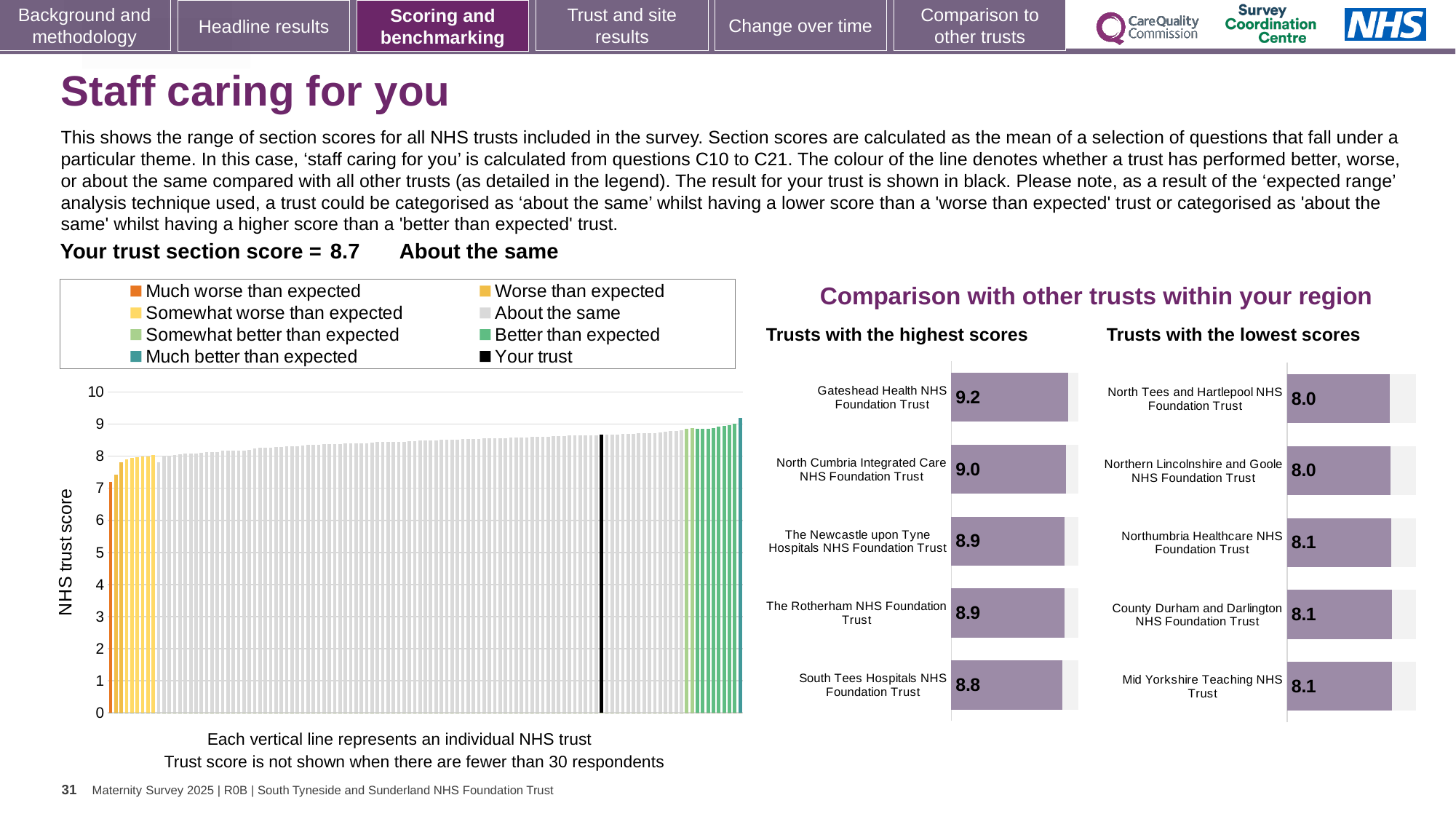
In the 'Trusts with the highest scores' chart, how many trusts are shown? 5 In the 'Trusts with the lowest scores' chart, which is larger, the score for Northumbria Healthcare NHS Foundation Trust or North Tees and Hartlepool NHS Foundation Trust? Northumbria Healthcare NHS Foundation Trust In the 'Trusts with the highest scores' chart, which trust has the highest score? Gateshead Health NHS Foundation Trust In the 'NHS trust score' chart on the left, is the value of the leftmost (orange) bar greater or less than 8? less In the 'NHS trust score' chart on the left, do the bar values rise or fall from left to right? Rise In the 'Trusts with the lowest scores' chart, what is the score for Mid Yorkshire Teaching NHS Trust? 8.1 In the 'Trusts with the highest scores' chart, what is the difference between the scores of Gateshead Health NHS Foundation Trust and South Tees Hospitals NHS Foundation Trust? 0.4 In the 'Trusts with the lowest scores' chart, what is the difference between the scores of County Durham and Darlington NHS Foundation Trust and Northern Lincolnshire and Goole NHS Foundation Trust? 0.1 What kind of chart is the 'NHS trust score' chart on the left of the slide? Bar chart In the 'Trusts with the highest scores' chart, what is the score for Gateshead Health NHS Foundation Trust? 9.2 In the 'NHS trust score' chart on the left, what is the section score for your trust (the black bar)? 8.7 How many entries does the legend of the 'NHS trust score' chart on the left list? 8